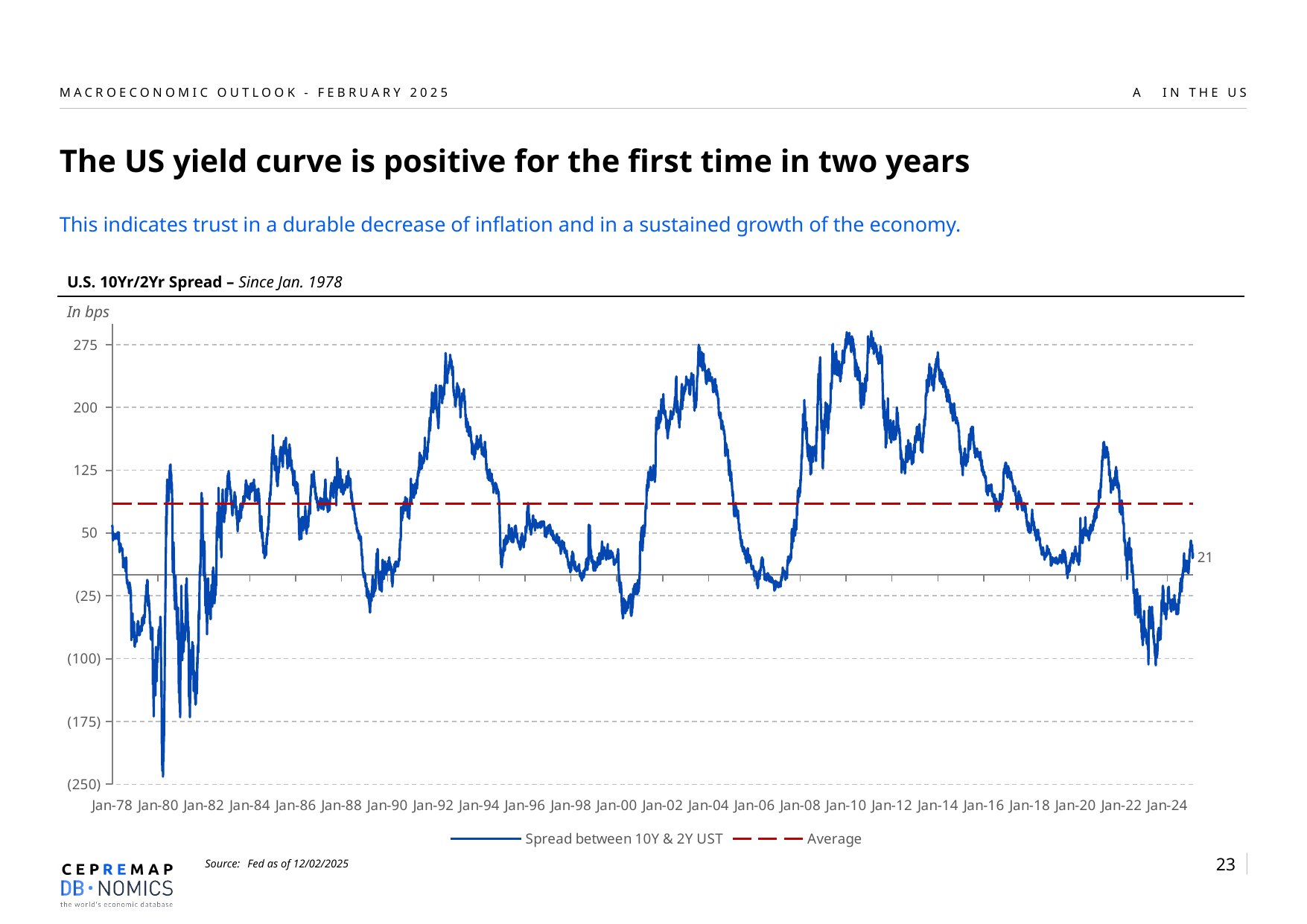
What kind of chart is shown on the slide? line chart What is the latest value of the spread labelled at the right end of the line? 21 What are the two legend entries of the chart? Spread between 10Y & 2Y UST; Average How many year labels are shown on the x axis? 24 Is the dashed Average line greater or less than 50? greater Is the peak of the spread around Jan-10 greater or less than 275? greater Between Jan-04 and Jan-06, does the spread rise or fall? fall Is the peak of the spread around Jan-92 greater or less than 200? greater How many series does the legend list? 2 What unit is the spread measured in, according to the chart? In bps